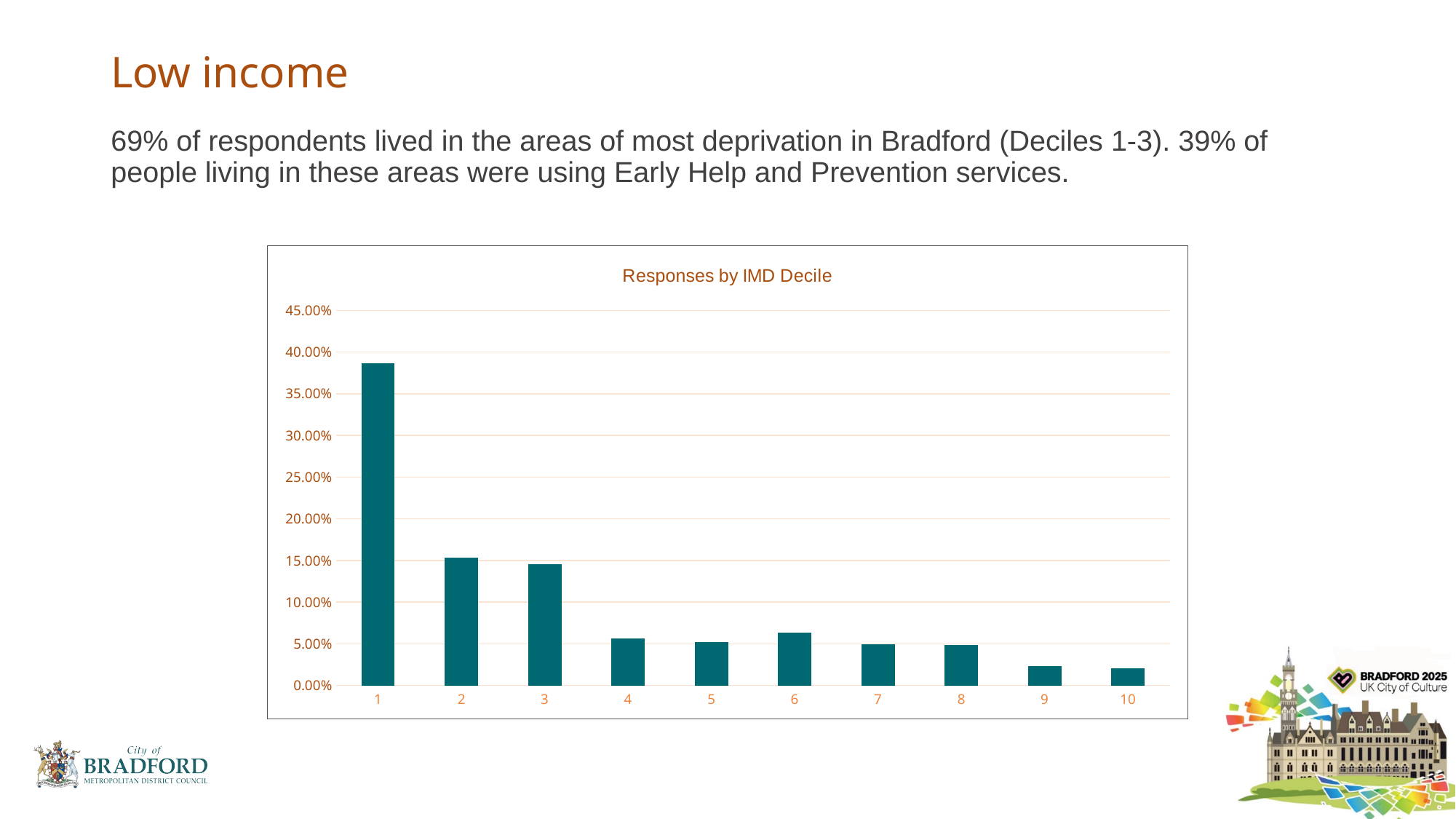
Is the value for decile 1 greater or less than 35.00%? greater Is the value for decile 3 greater or less than 20.00%? less Is the value for decile 2 greater or less than 10.00%? greater Do the values generally rise or fall as the IMD decile increases from 1 to 10? fall Which has a larger share of responses, decile 1 or decile 2? decile 1 How many IMD deciles are plotted on the x axis? 10 Which IMD decile has the highest share of responses? 1 What kind of chart is shown on the slide? bar chart Which has a larger share of responses, decile 2 or decile 4? decile 2 What is the title of the chart? Responses by IMD Decile